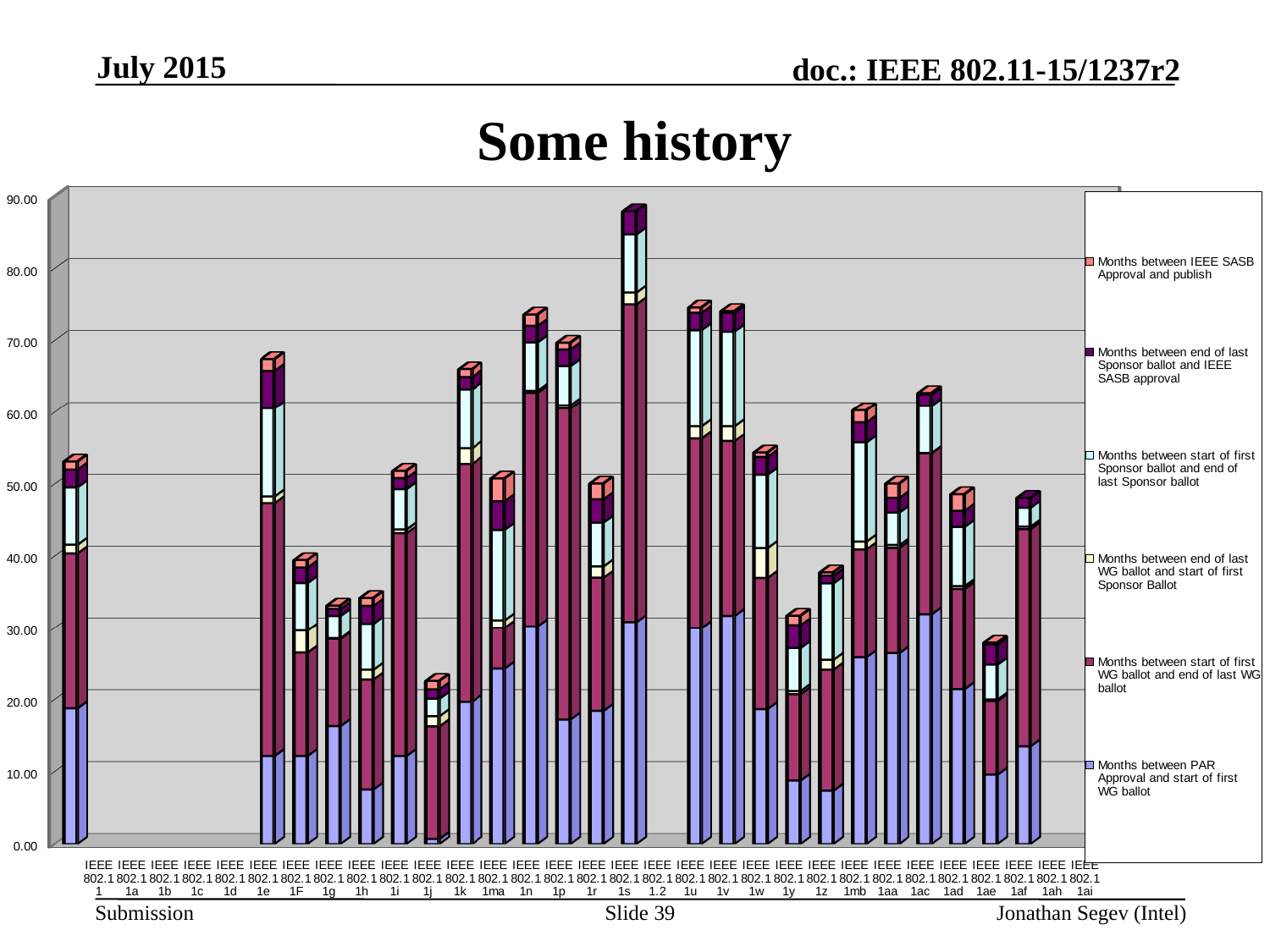
Which has the taller stacked bar, IEEE 802.11k or IEEE 802.11h? IEEE 802.11k How many series does the legend list? 6 How many categories are labelled along the x axis? 31 Is the total stacked value for IEEE 802.11j greater or less than 30? less Which legend entry is shown at the bottom of the legend? Months between PAR Approval and start of first WG ballot Which category has the tallest stacked bar? IEEE 802.11s What is the title of the chart? Some history Which has the taller stacked bar, IEEE 802.11s or IEEE 802.11e? IEEE 802.11s Is the total stacked value for IEEE 802.11g greater or less than 40? less Is the total stacked value for IEEE 802.11s greater or less than 80? greater What kind of chart is shown on the slide? Stacked bar chart